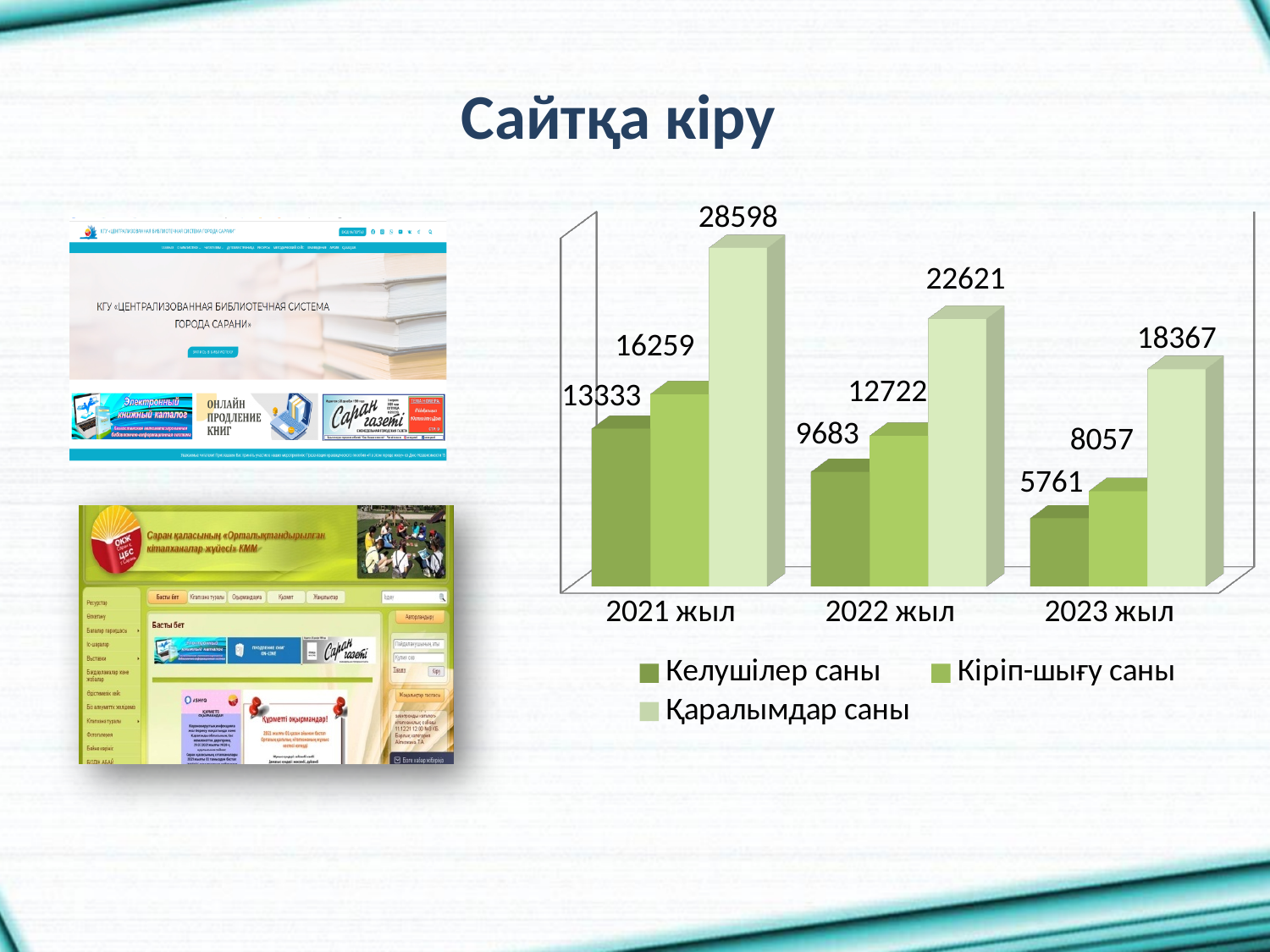
How many year categories are shown on the x axis of the chart? 3 What is the value of Кіріп-шығу саны for 2023 жыл? 8057 What is the difference between Қаралымдар саны and Келушілер саны in 2021 жыл? 15265 What is the value of Келушілер саны for 2021 жыл? 13333 In which year is Қаралымдар саны the highest? 2021 жыл How many series does the chart legend list? 3 In which year is Келушілер саны the lowest? 2023 жыл What is the value of Қаралымдар саны for 2022 жыл? 22621 Which is larger: Кіріп-шығу саны in 2022 жыл or Қаралымдар саны in 2023 жыл? Қаралымдар саны in 2023 жыл What is the title of the slide containing the chart? Сайтқа кіру What type of chart is shown on the slide? bar chart How does Келушілер саны change from 2021 жыл to 2023 жыл? It falls